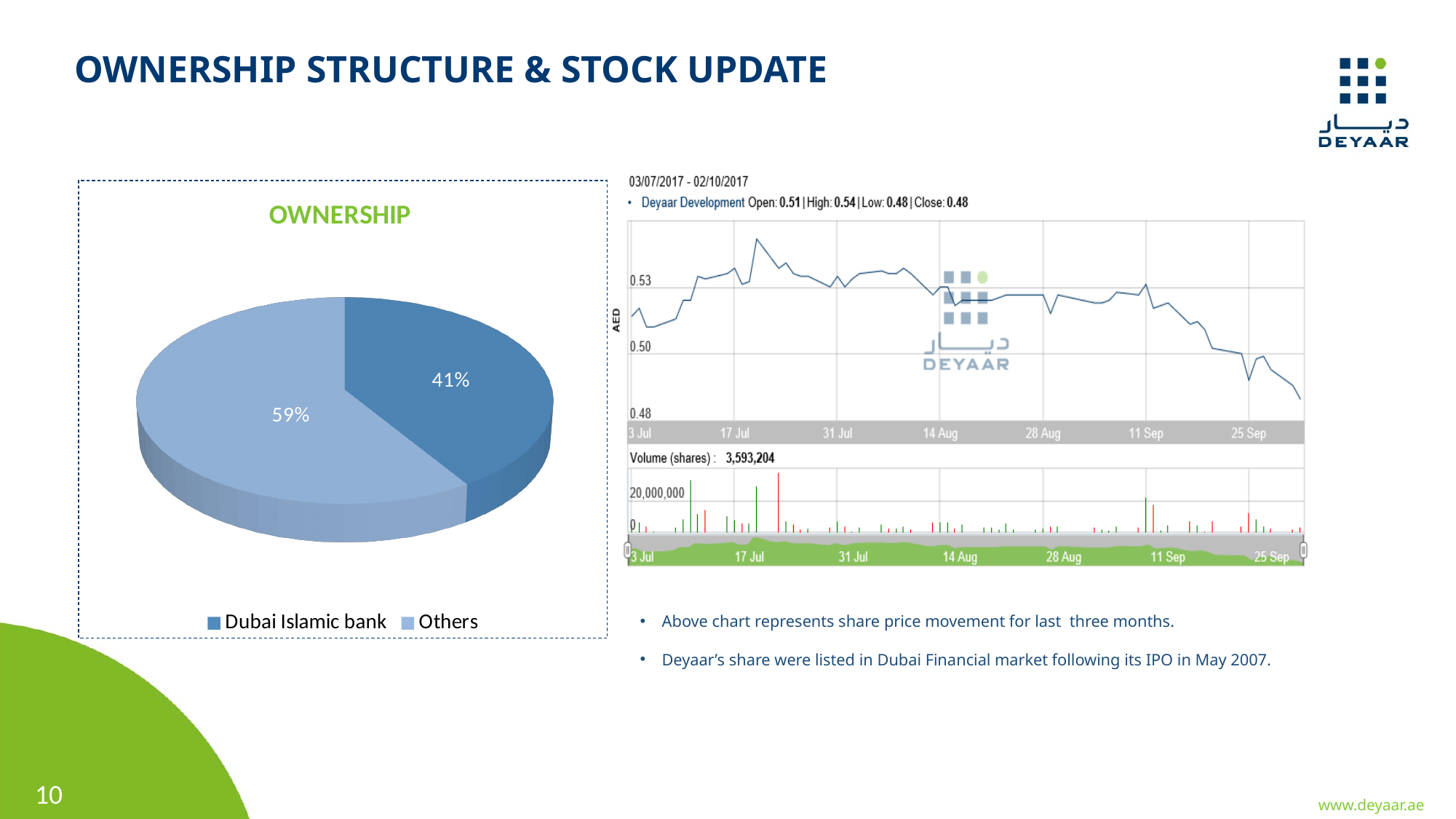
On the OWNERSHIP chart, how many slices does the pie have? 2 On the OWNERSHIP chart, what kind of chart is shown? Pie chart On the share price chart on the right, what is the high price shown for Deyaar Development? 0.54 On the share price chart on the right, what is the closing price shown for Deyaar Development? 0.48 On the share price chart on the right, does the share price overall rise or fall from 3 Jul to the end of the period? Fall On the share price chart on the right, is the share price at 14 Aug greater or less than 0.50? greater On the OWNERSHIP chart, which colour represents Dubai Islamic bank? Dark blue On the OWNERSHIP chart, which slice is larger, Dubai Islamic bank or Others? Others On the OWNERSHIP chart, what is the difference in percentage points between the Others slice and the Dubai Islamic bank slice? 18 percentage points On the OWNERSHIP chart, how many entries does the legend list? 2 On the OWNERSHIP chart, what share of ownership is held by Others? 59% On the OWNERSHIP chart, what share of ownership is held by Dubai Islamic bank? 41%